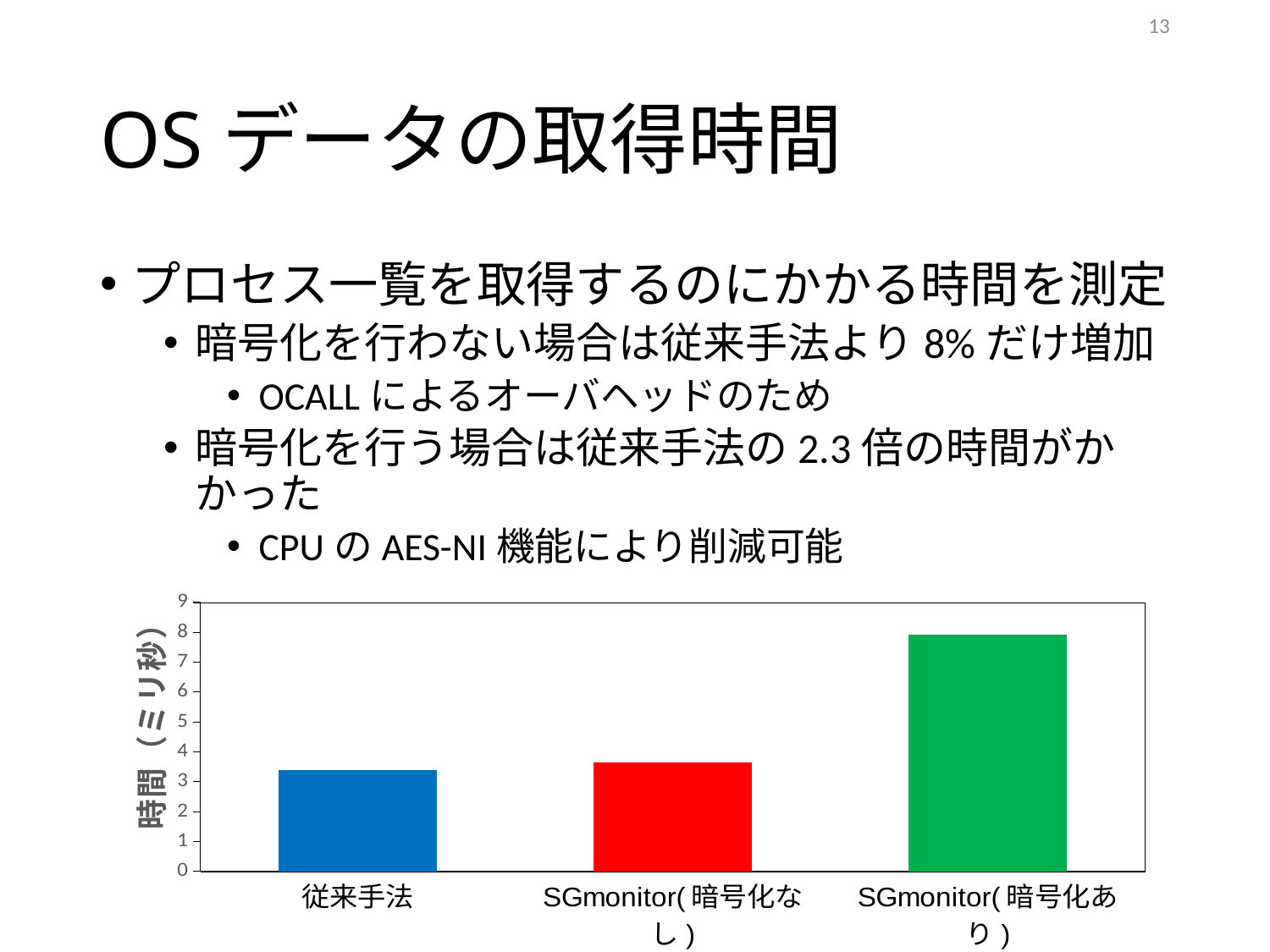
Is the value for SGmonitor(暗号化あり) greater or less than 5? greater Is the value for SGmonitor(暗号化なし) greater or less than 4? less What is the label of the vertical axis of the chart? 時間（ミリ秒） What colour is the bar for SGmonitor(暗号化あり)? green Is the value for SGmonitor(暗号化あり) greater or less than 7? greater Which category has the highest value in the chart? SGmonitor(暗号化あり) How many bars (categories) does the chart show? 3 Which is larger, the value for SGmonitor(暗号化あり) or the value for 従来手法? SGmonitor(暗号化あり) Do the bar values rise or fall from left to right across the categories? rise What kind of chart is shown on the slide? bar chart